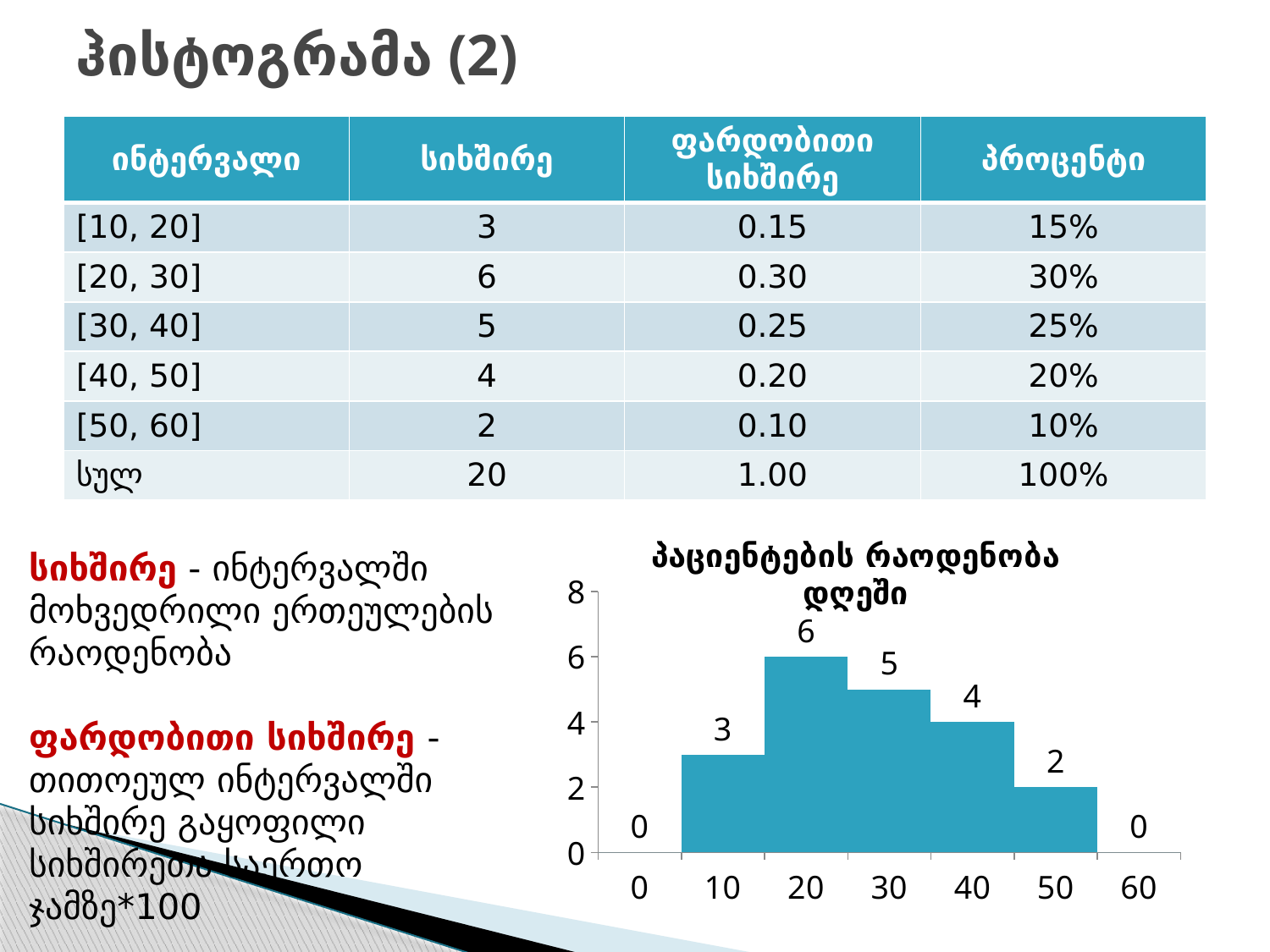
Is the value of the bar at x = 20 greater or less than 4? greater Which bar is taller, the one at x = 30 or the one at x = 40? 30 What is the value shown at x = 60 in the chart? 0 What is the value of the bar at x = 20 in the chart? 6 What is the value of the bar at x = 50 in the chart? 2 Among the non-zero bars, which x-axis value has the lowest bar? 50 What is the difference between the bar at x = 20 and the bar at x = 50? 4 What is the value of the bar at x = 10 in the chart? 3 What is the title of the chart on the slide? პაციენტების რაოდენობა დღეში What kind of chart is shown on the slide? bar chart At which x-axis value is the tallest bar in the chart? 20 Do the bar values rise or fall from x = 20 to x = 50? fall